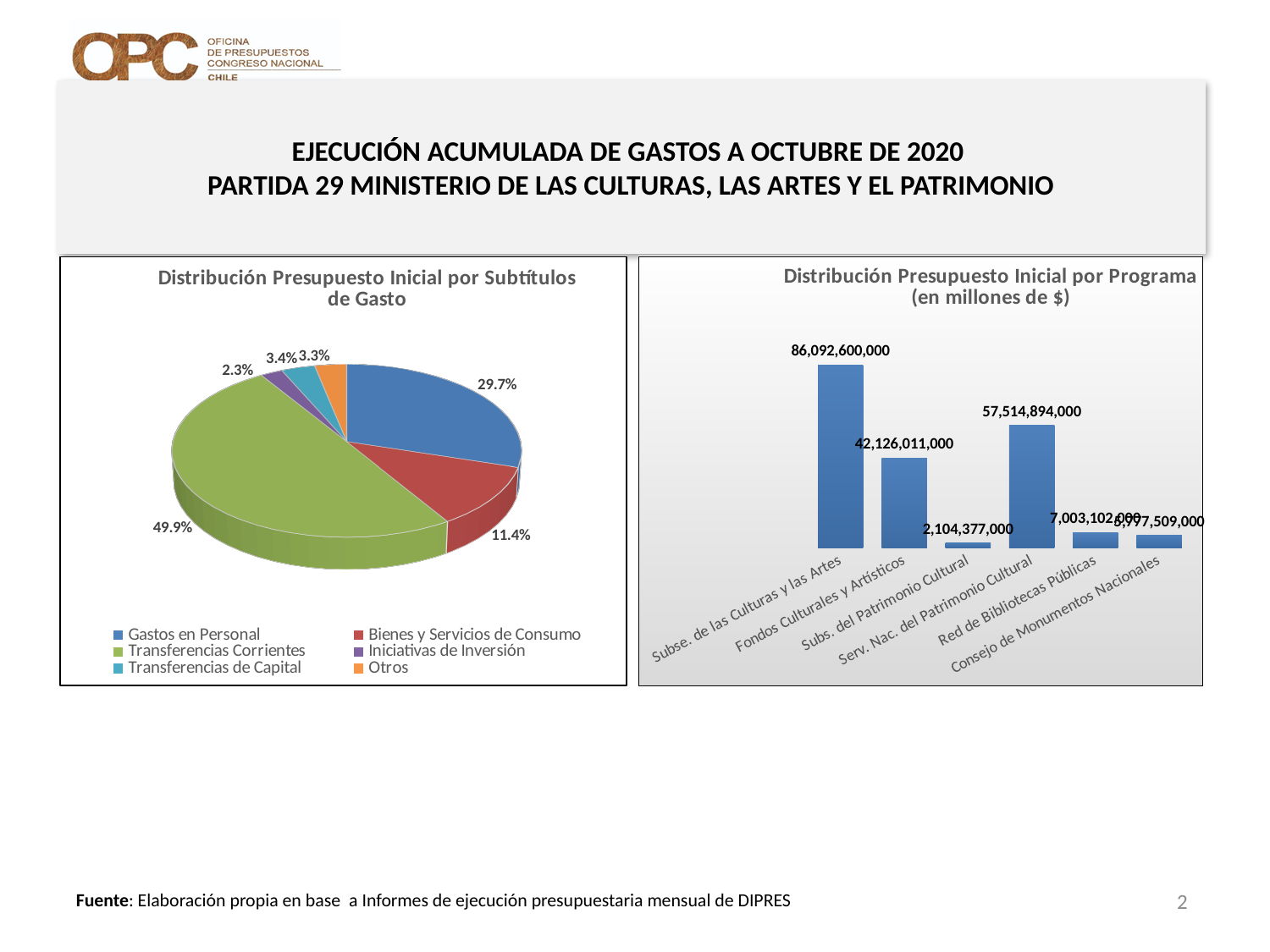
On the bar chart 'Distribución Presupuesto Inicial por Programa', what is the difference between Subse. de las Culturas y las Artes and Fondos Culturales y Artísticos? 43,966,589,000 On the pie chart 'Distribución Presupuesto Inicial por Subtítulos de Gasto', which category has the smallest share? Iniciativas de Inversión On the bar chart 'Distribución Presupuesto Inicial por Programa', what is the value for Serv. Nac. del Patrimonio Cultural? 57,514,894,000 On the bar chart 'Distribución Presupuesto Inicial por Programa', what is the value for Subse. de las Culturas y las Artes? 86,092,600,000 On the pie chart 'Distribución Presupuesto Inicial por Subtítulos de Gasto', what is the difference in percentage points between Transferencias Corrientes and Gastos en Personal? 20.2 percentage points On the bar chart 'Distribución Presupuesto Inicial por Programa', which is larger: Fondos Culturales y Artísticos or Serv. Nac. del Patrimonio Cultural? Serv. Nac. del Patrimonio Cultural On the pie chart 'Distribución Presupuesto Inicial por Subtítulos de Gasto', what share does Transferencias Corrientes have? 49.9% On the pie chart 'Distribución Presupuesto Inicial por Subtítulos de Gasto', how many categories does the legend list? 6 On the pie chart 'Distribución Presupuesto Inicial por Subtítulos de Gasto', what percentage is shown for Gastos en Personal? 29.7% On the pie chart 'Distribución Presupuesto Inicial por Subtítulos de Gasto', which colour represents Bienes y Servicios de Consumo? Red On the bar chart 'Distribución Presupuesto Inicial por Programa', which program has the lowest value? Subs. del Patrimonio Cultural What kind of chart is 'Distribución Presupuesto Inicial por Programa (en millones de $)'? Bar chart